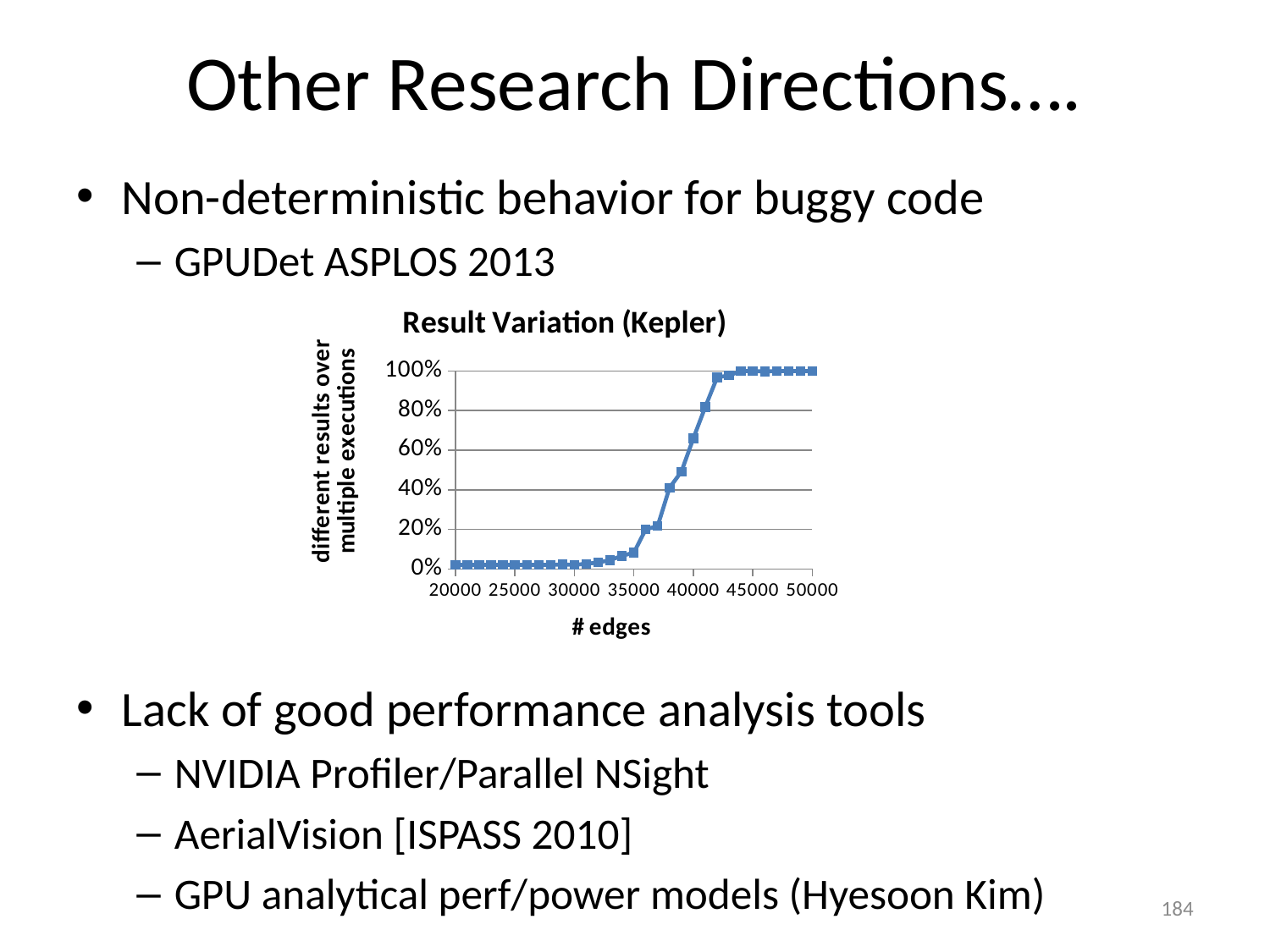
What is the title of the chart on the slide? Result Variation (Kepler) Is the value at 40000 edges greater or less than 80%? less Which has the larger value: 30000 edges or 40000 edges? 40000 edges Is the value at 30000 edges greater or less than 20%? less Is the value at 35000 edges greater or less than 20%? less What is the value plotted at 50000 edges? 100% What is the label of the x axis of the chart? # edges Does the plotted value rise or fall as # edges increases from 20000 to 50000? rise What kind of chart is shown under 'Result Variation (Kepler)'? line chart